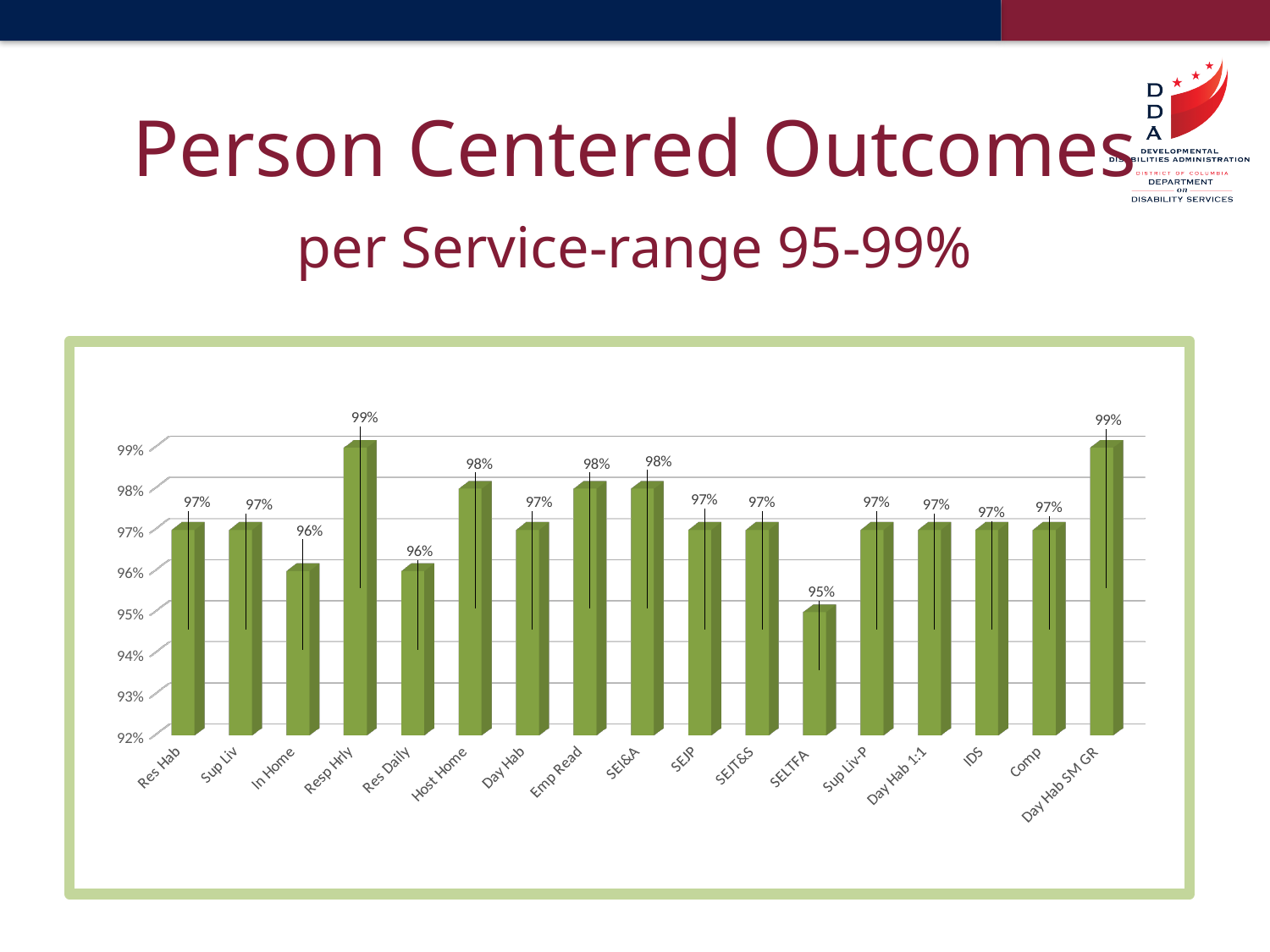
What kind of chart is shown on the slide? Bar chart What is the value for Host Home? 98% What is the value for Day Hab SM GR? 99% How many services are shown on the x axis? 17 Which service has the lowest value? SELTFA What is the title of the slide containing the chart? Person Centered Outcomes per Service-range 95-99% Which is larger, the value for SEI&A or the value for SEJP? SEI&A What is the difference between the values for Emp Read and Res Daily? 2% Which two services share the highest value of 99%? Resp Hrly and Day Hab SM GR What is the value for In Home? 96% What is the difference between the values for Resp Hrly and SELTFA? 4% What is the value for SELTFA? 95%